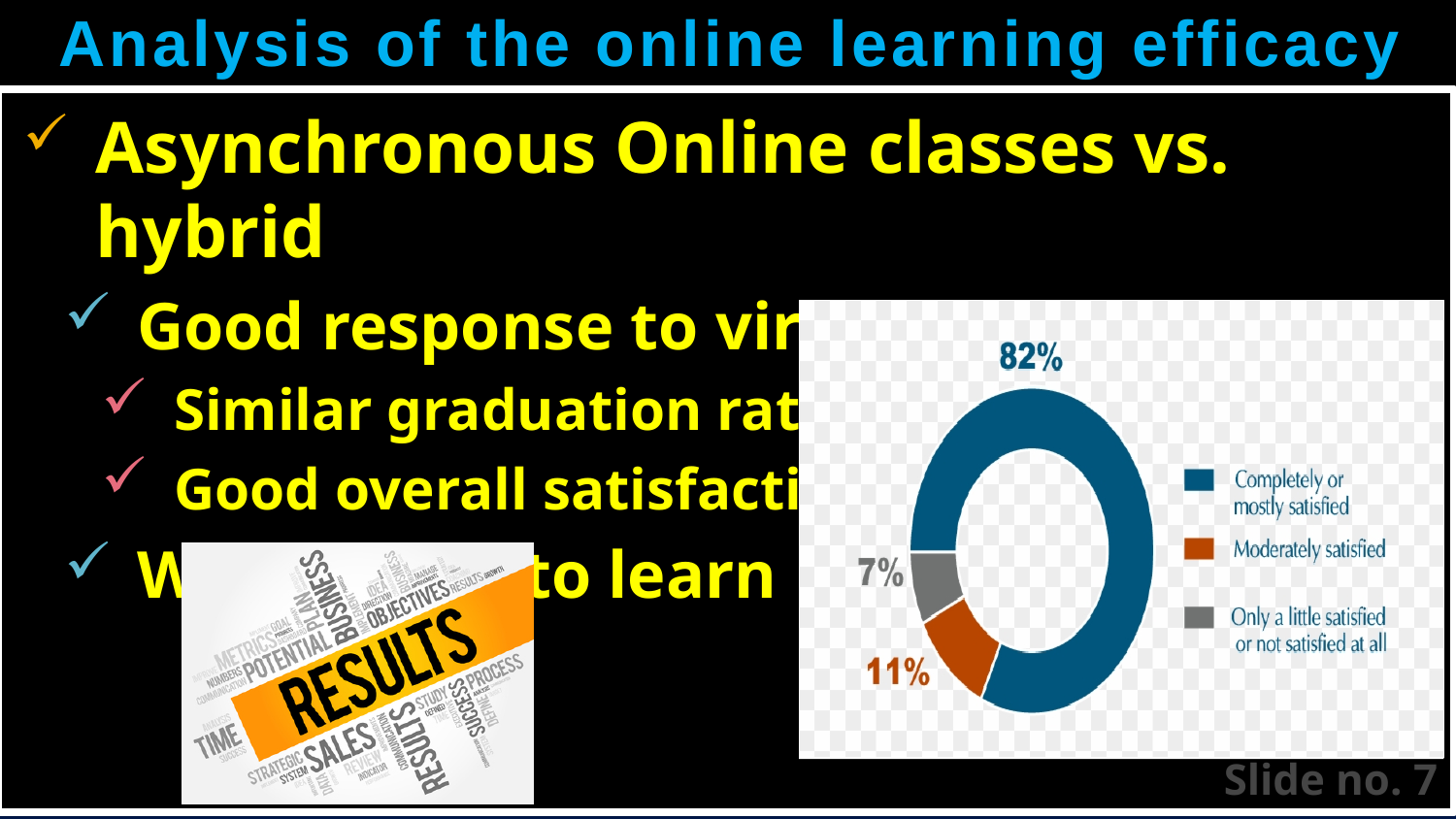
Which category has the smallest share of the chart? Only a little satisfied or not satisfied at all What colour represents the 'Completely or mostly satisfied' category? Blue What percentage of respondents were completely or mostly satisfied? 82% What colour represents the 'Moderately satisfied' category? Orange (brown) What percentage of respondents were moderately satisfied? 11% How many categories does the chart show? 3 What percentage of respondents were only a little satisfied or not satisfied at all? 7% What is the difference between the share of completely or mostly satisfied and moderately satisfied respondents? 71% What is the combined share of moderately satisfied and only a little satisfied or not satisfied at all respondents? 18% Which category has the largest share of the chart? Completely or mostly satisfied Which is larger: the share of moderately satisfied respondents or the share of only a little satisfied or not satisfied at all? Moderately satisfied What kind of chart is shown on the slide? Donut (pie) chart